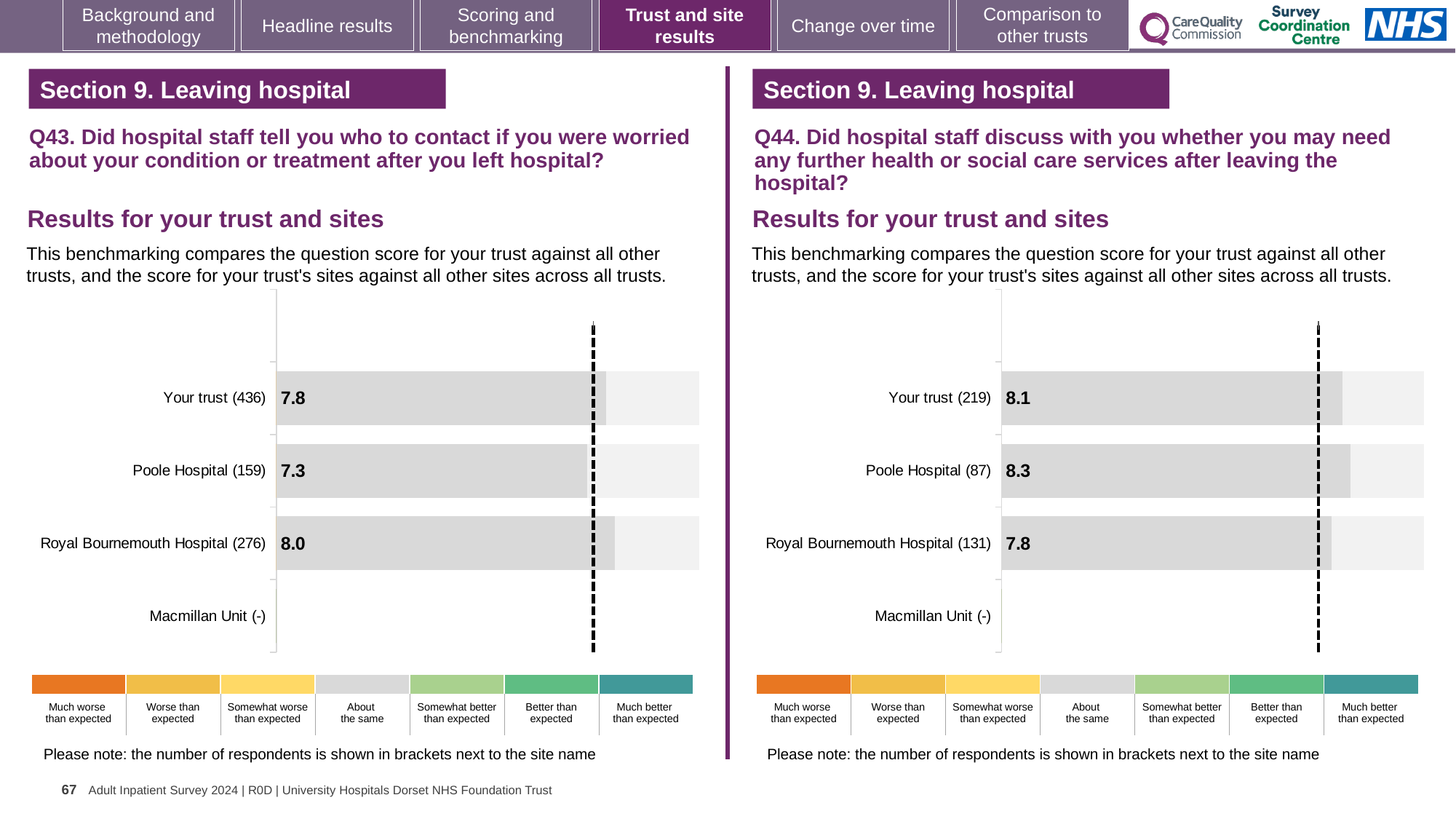
In the Q43 chart on the left, what is the difference between the scores for Royal Bournemouth Hospital and Poole Hospital? 0.7 In the Q44 chart on the right, what is the difference between the scores for Poole Hospital and Your trust? 0.2 In the Q43 chart on the left, what is the score for Your trust? 7.8 In the Q44 chart on the right, what is the score for Royal Bournemouth Hospital? 7.8 In the Q43 chart on the left, how many respondents are shown in brackets for Your trust? 436 In the Q43 chart on the left, which site has the highest score? Royal Bournemouth Hospital What kind of chart is used in the Q44 chart on the right? Bar chart In the Q44 chart on the right, which is larger, the score for Your trust or the score for Poole Hospital? Poole Hospital In the Q44 chart on the right, which site has the lowest score among those with a value shown? Royal Bournemouth Hospital In the Q43 chart on the left, what is the score for Poole Hospital? 7.3 How many row labels (sites including Your trust) are listed in the Q43 chart on the left? 4 In the Q44 chart on the right, what is the score for Poole Hospital? 8.3